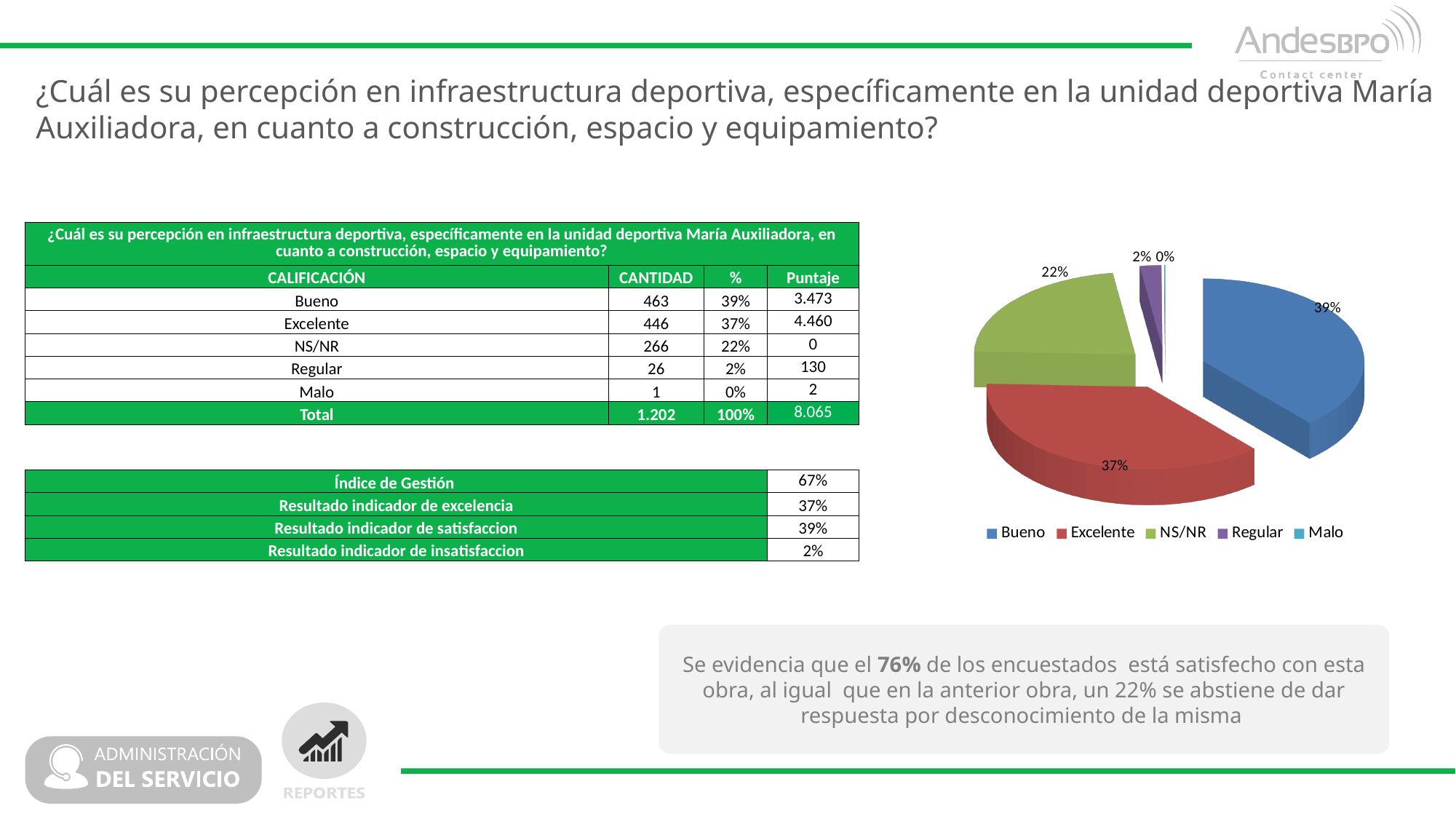
What kind of chart is shown on the slide? pie chart What colour is the Excelente slice in the pie chart? red Which category has the smallest slice in the pie chart? Malo What is the difference in percentage points between the NS/NR slice and the Regular slice? 20 What percentage does the Regular slice show in the pie chart? 2% Which category has the largest slice in the pie chart? Bueno What percentage does the Bueno slice show in the pie chart? 39% Which slice is larger in the pie chart, NS/NR or Regular? NS/NR What percentage does the NS/NR slice show in the pie chart? 22% How many categories does the legend of the pie chart list? 5 What percentage does the Excelente slice show in the pie chart? 37% What percentage does the Malo slice show in the pie chart? 0%